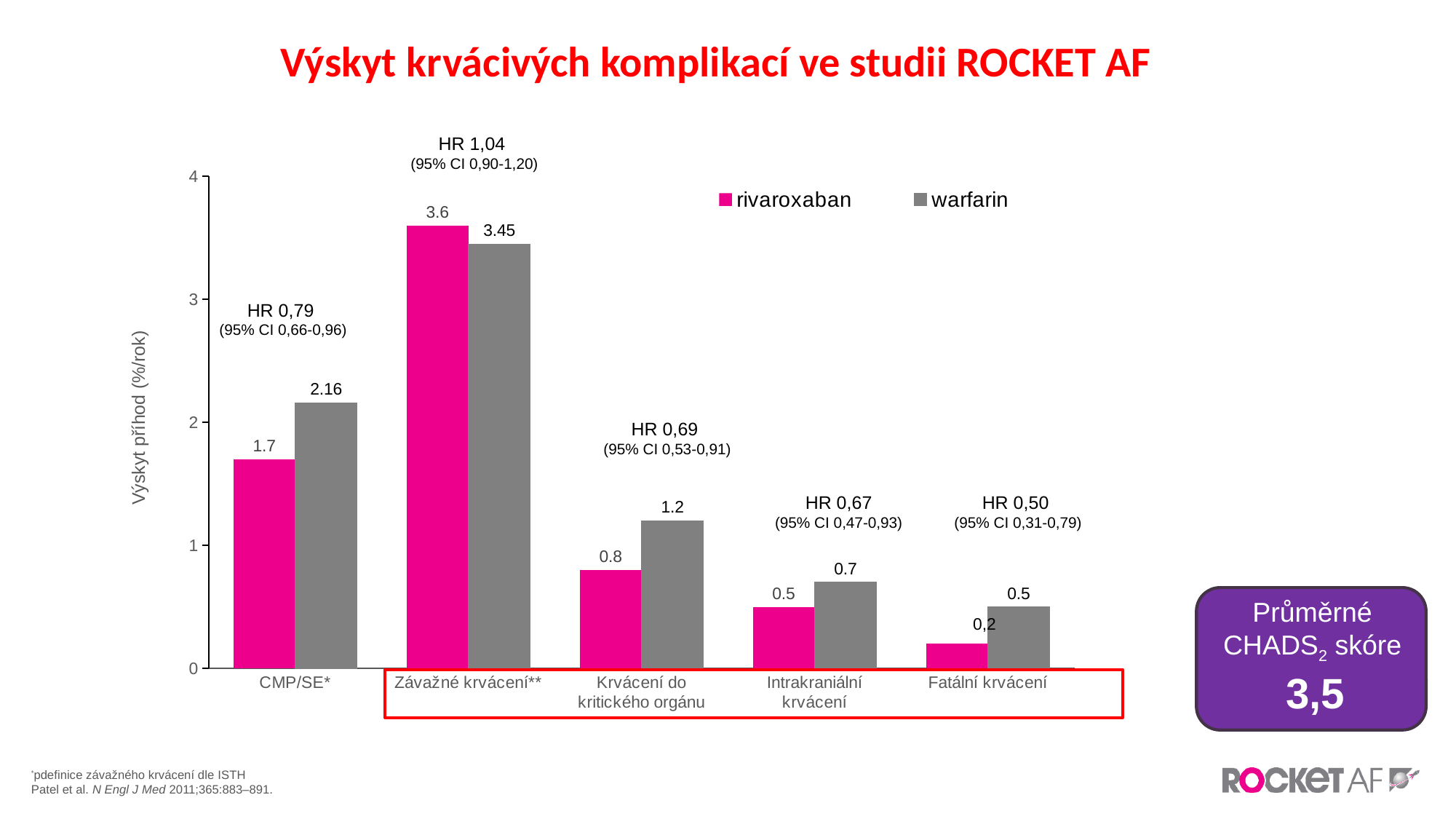
What is the rivaroxaban value for CMP/SE*? 1.7 What is the hazard ratio (HR) shown above the Závažné krvácení** bars? HR 1,04 Which category has the highest rivaroxaban value? Závažné krvácení** How many categories are shown on the x axis? 5 What kind of chart is shown on the slide? bar chart What is the warfarin value for Závažné krvácení**? 3.45 What is the rivaroxaban value for Fatální krvácení? 0.2 What is the difference between the warfarin and rivaroxaban values for CMP/SE*? 0.46 How many series does the legend list? 2 Which is larger for Intrakraniální krvácení, the rivaroxaban value or the warfarin value? warfarin What is the warfarin value for Krvácení do kritického orgánu? 1.2 Which category has the lowest warfarin value? Fatální krvácení